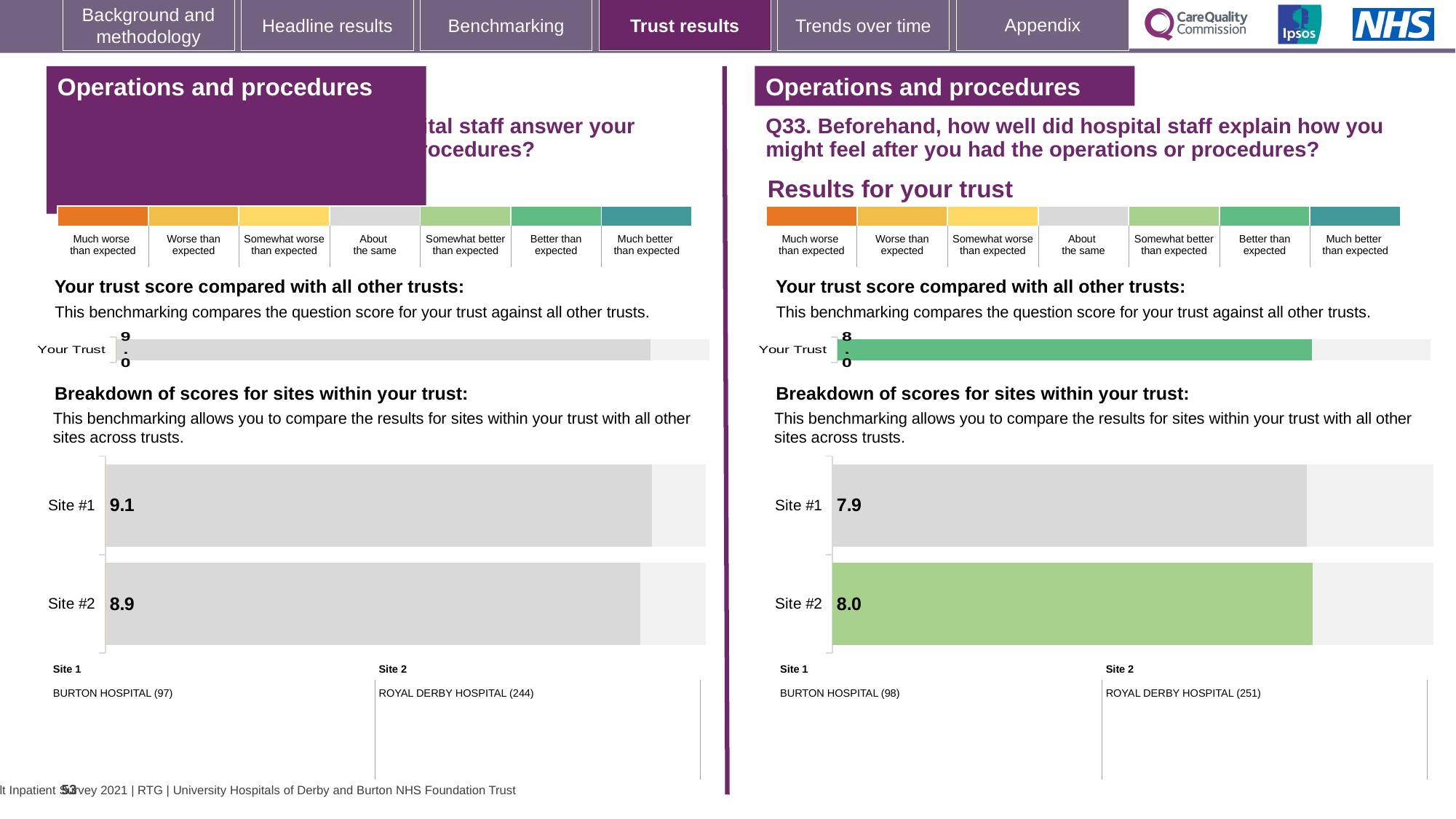
On the left-hand chart, what is the score for Site #2? 8.9 On the left-hand site breakdown chart, what is the difference between the Site #1 and Site #2 scores? 0.2 On the right-hand (Q33) chart, what is the score for Site #2? 8.0 On the right-hand (Q33) chart, what is the score for Site #1? 7.9 On the right-hand (Q33) site breakdown chart, what is the difference between the Site #2 and Site #1 scores? 0.1 On the left-hand chart, what is the score for Site #1? 9.1 On the left-hand site breakdown chart, which site has the higher score? Site #1 What type of chart is used for the site breakdown on the right-hand (Q33) side? Bar chart On the right-hand (Q33) 'Your Trust' bar, what is the trust score? 8.0 How many sites are shown in the right-hand (Q33) site breakdown chart? 2 On the left-hand 'Your Trust' bar, what is the trust score? 9.0 On the right-hand (Q33) site breakdown chart, which site has the lower score? Site #1